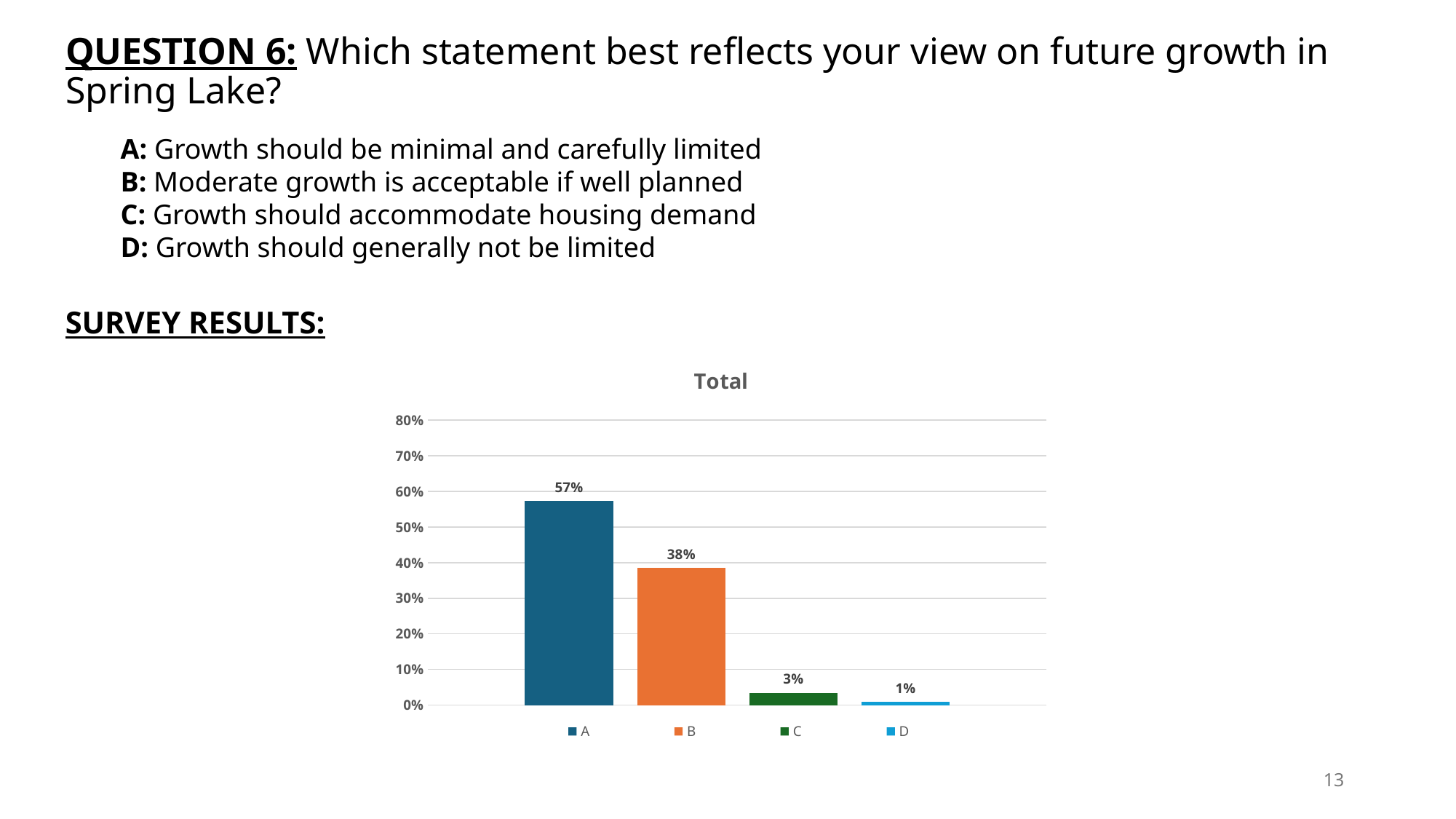
What percentage of respondents chose option B? 38% What percentage of respondents chose option D? 1% What is the title of the chart? Total What is the difference in percentage points between option A and option B? 19% How many options are plotted in the chart? 4 Which option received the lowest share of responses? D What percentage of respondents chose option A? 57% What type of chart is shown on the slide? Bar chart Which received a larger share of responses, option B or option C? B Is the value for option A greater or less than 50%? greater What percentage of respondents chose option C? 3% Which option received the highest share of responses? A